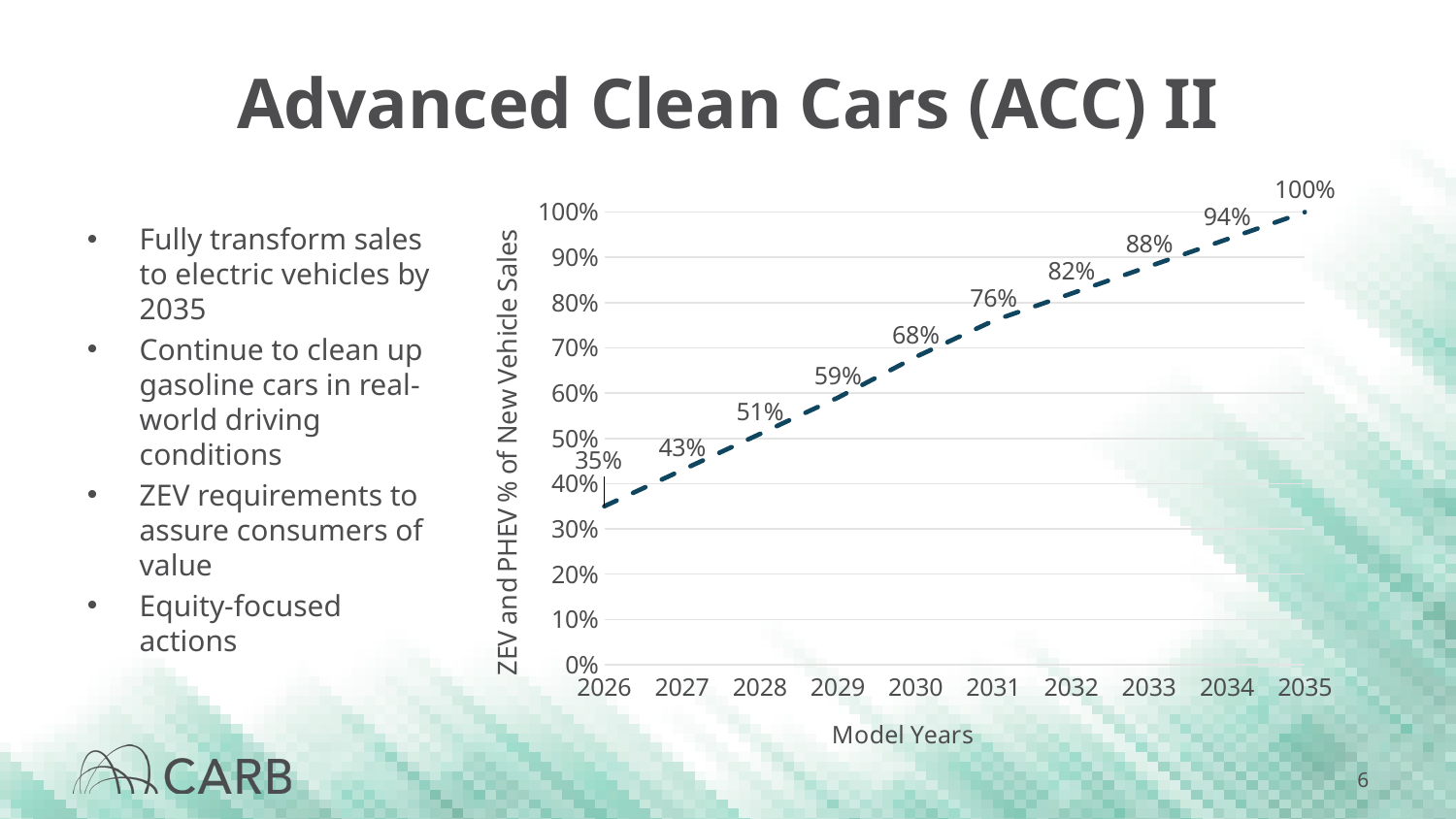
How many model years are plotted on the chart? 10 What is the label of the x axis? Model Years What is the ZEV and PHEV % of new vehicle sales for model year 2026? 35% What is the difference between the values for 2029 and 2028? 8% What is the ZEV and PHEV % of new vehicle sales for model year 2033? 88% What is the ZEV and PHEV % of new vehicle sales for model year 2030? 68% Which model year has the lowest ZEV and PHEV % of new vehicle sales? 2026 Which model year has the highest ZEV and PHEV % of new vehicle sales? 2035 What kind of chart is shown on the slide? Line chart What is the difference between the values for 2035 and 2026? 65% Do the values rise or fall from 2026 to 2035? Rise Which model year has a higher value, 2031 or 2029? 2031